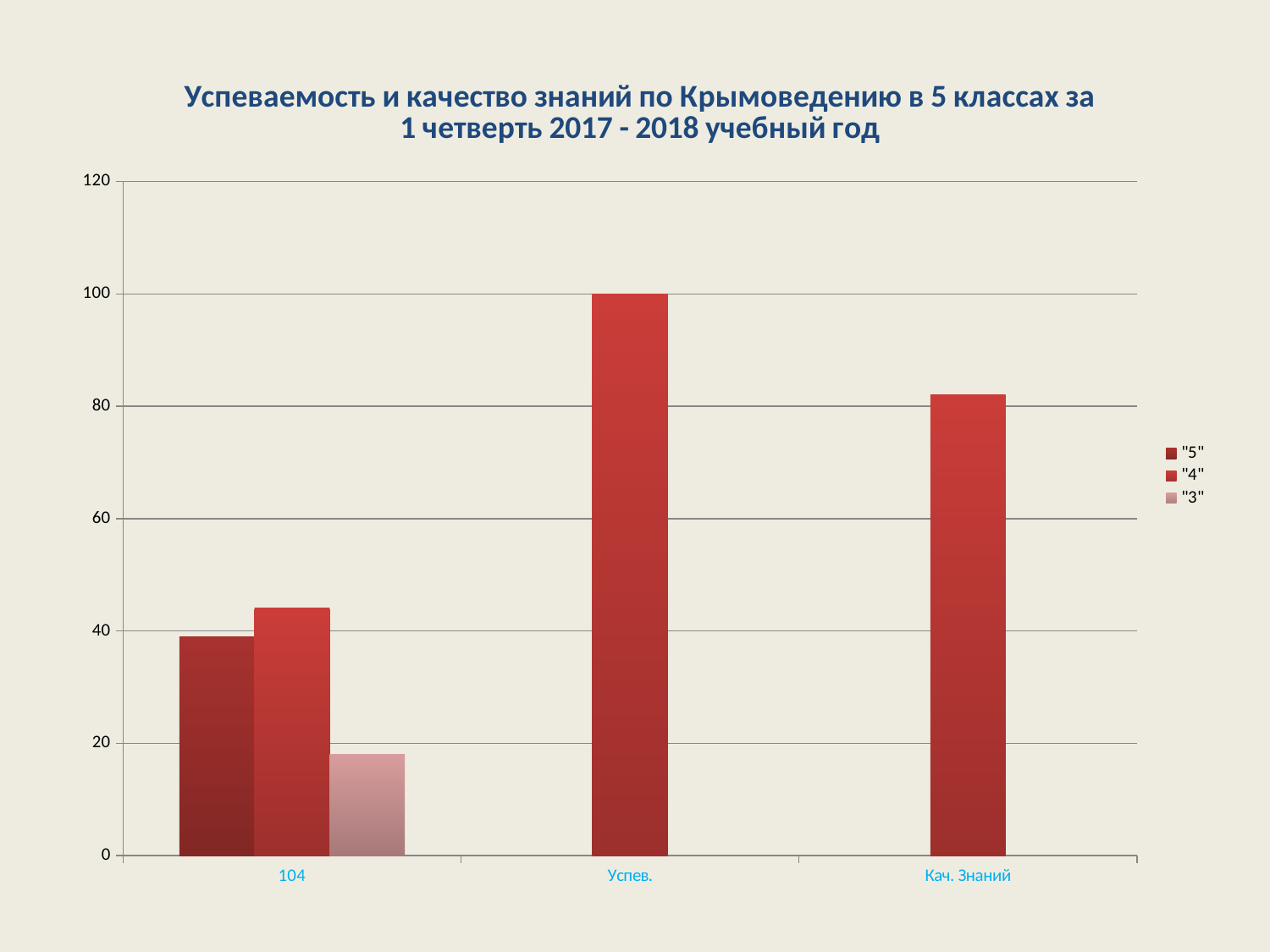
Is the value for Кач. Знаний greater or less than 80? greater Within the category 104, which series has the lowest bar? "3" Which is larger: the bar for Успев. or the bar for Кач. Знаний? Успев. Which category has the highest bar? Успев. What is the title of the chart? Успеваемость и качество знаний по Крымоведению в 5 классах за 1 четверть 2017 - 2018 учебный год How many categories are shown on the x axis? 3 Is the value of the "4" series for the category 104 greater or less than 40? greater Is the value of the "3" series for the category 104 greater or less than 20? less How many series does the legend list? 3 What kind of chart is shown on the slide? bar chart